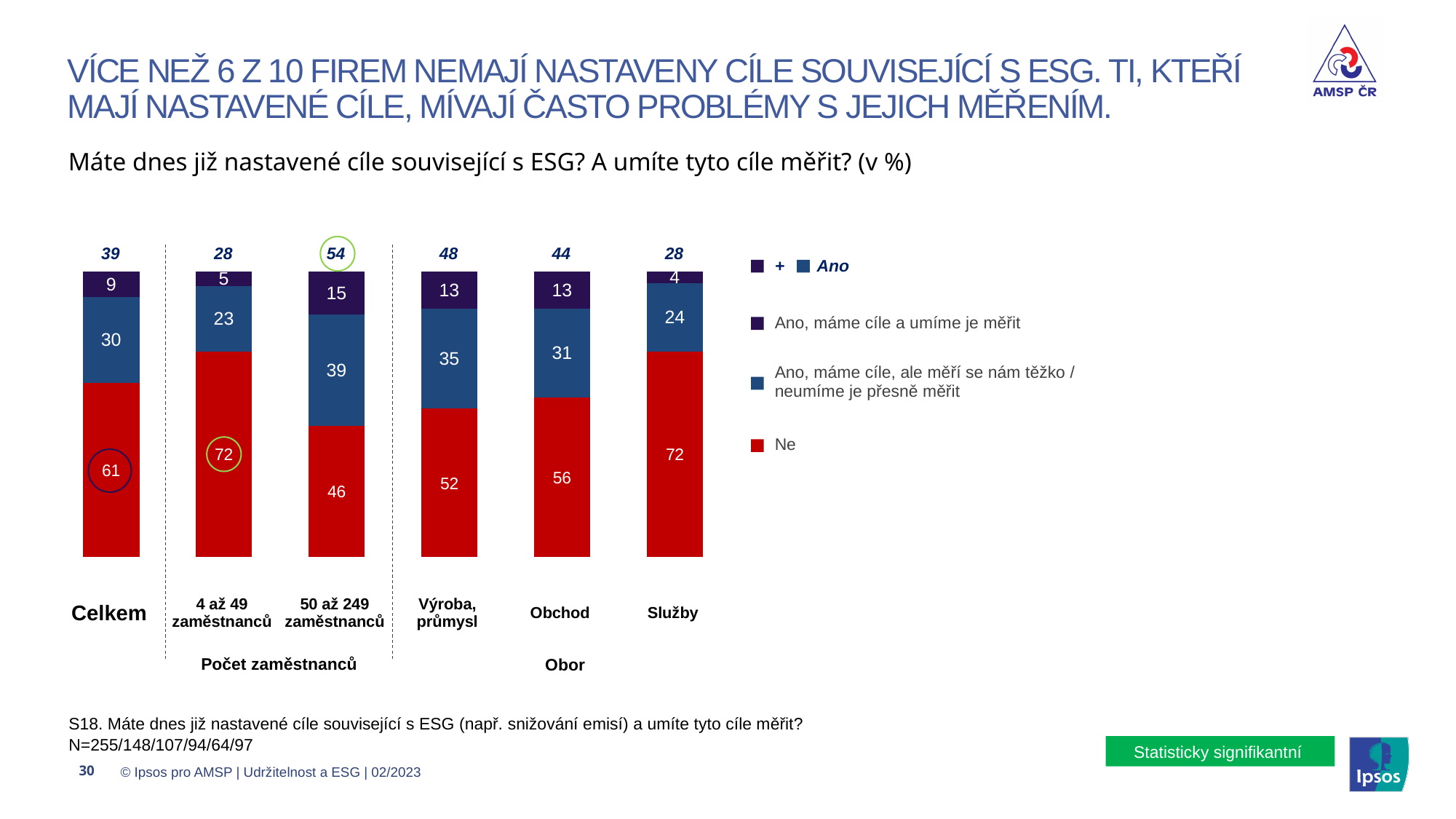
What is the difference between the "Ne" values for 4 až 49 zaměstnanců and 50 až 249 zaměstnanců? 26 What kind of chart is shown on the slide? Stacked bar chart Which category has the lowest value for "Ano, máme cíle a umíme je měřit"? Služby How many categories (bars) are shown in the chart? 6 Which category has the highest combined "Ano" value shown above the bars? 50 až 249 zaměstnanců Which category has the highest value for "Ne"? 4 až 49 zaměstnanců and Služby (both 72) What is the combined "Ano" value shown above the bar for Výroba, průmysl? 48 Which is larger: the "Ano, máme cíle, ale měří se nám těžko" value for Výroba, průmysl or for Služby? Výroba, průmysl How many series does the legend list? 3 What is the value of "Ne" for Celkem? 61 What is the value of "Ano, máme cíle a umíme je měřit" for 50 až 249 zaměstnanců? 15 What is the value of "Ano, máme cíle, ale měří se nám těžko / neumíme je přesně měřit" for Obchod? 31